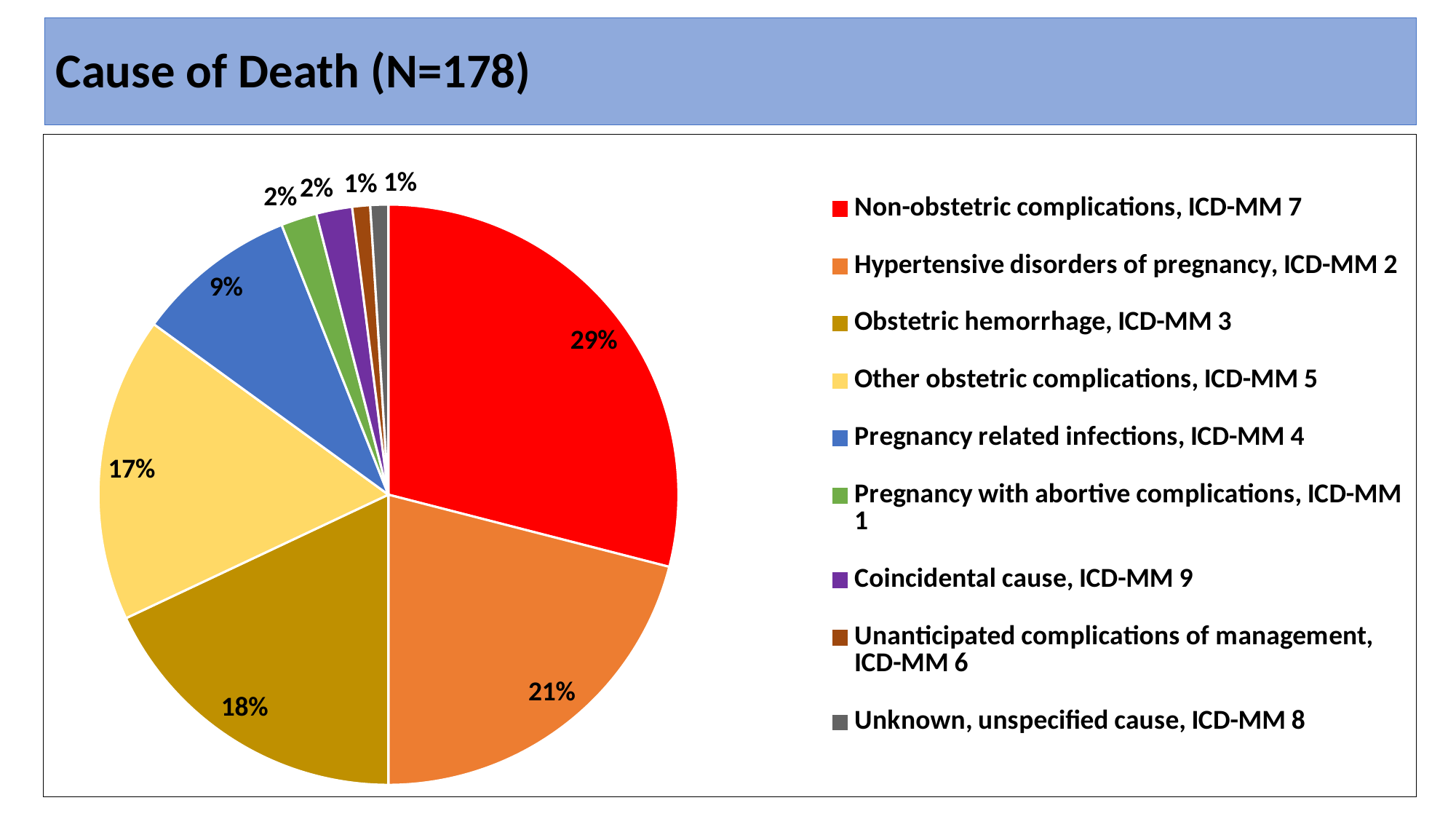
What is the difference in percentage points between Non-obstetric complications, ICD-MM 7 and Hypertensive disorders of pregnancy, ICD-MM 2? 8 percentage points What kind of chart is shown on the slide? Pie chart What share of the pie is Non-obstetric complications, ICD-MM 7? 29% Which is larger: the share for Obstetric hemorrhage, ICD-MM 3 or the share for Pregnancy related infections, ICD-MM 4? Obstetric hemorrhage, ICD-MM 3 What share of the pie is Other obstetric complications, ICD-MM 5? 17% How many categories does the legend list? 9 What colour is the slice for Pregnancy related infections, ICD-MM 4? Blue What share of the pie is Obstetric hemorrhage, ICD-MM 3? 18% What is the title of the chart? Cause of Death (N=178) Which cause of death has the largest share of the pie? Non-obstetric complications, ICD-MM 7